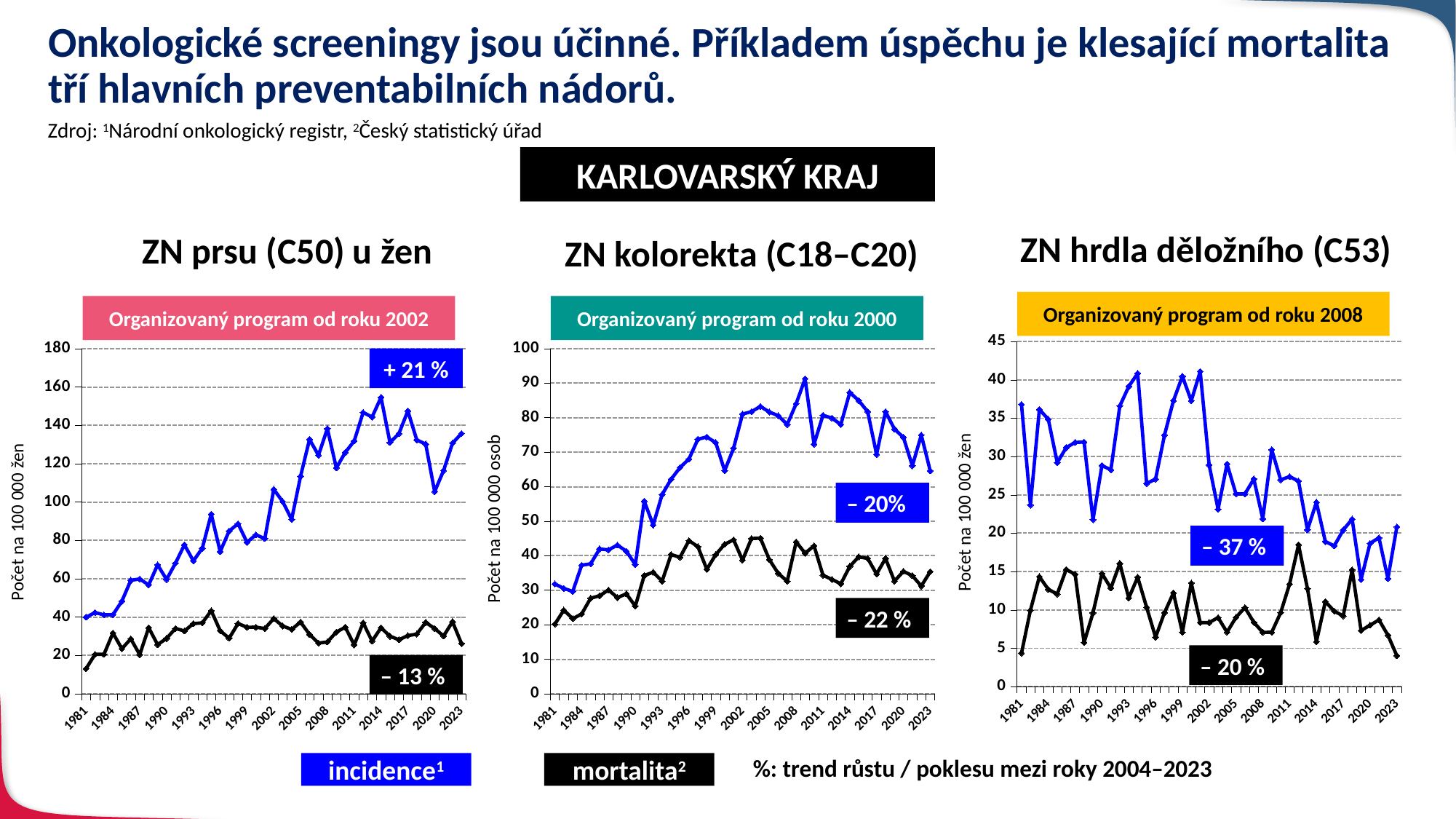
In the ZN kolorekta (C18–C20) chart, what is the trend percentage shown for mortalita? – 22 % In the ZN prsu (C50) u žen chart, what is the trend percentage shown for mortalita? – 13 % What kind of chart is used for ZN prsu (C50) u žen? line chart How many charts are shown on the slide? 3 In the ZN prsu (C50) u žen chart, is the incidence value for 2023 greater or less than 120? greater In the ZN prsu (C50) u žen chart, does the incidence line generally rise or fall from 1981 to 2023? rise How many series does the legend at the bottom of the slide list? 2 In the ZN hrdla děložního (C53) chart, is the mortalita value for 2023 greater or less than 10? less In the ZN kolorekta (C18–C20) chart, what is the trend percentage shown for incidence? – 20% In the ZN hrdla děložního (C53) chart, from which year has the organized program been running? 2008 In the ZN hrdla děložního (C53) chart, what is the trend percentage shown for incidence? – 37 % In the ZN prsu (C50) u žen chart, what is the trend percentage shown for incidence? + 21 %